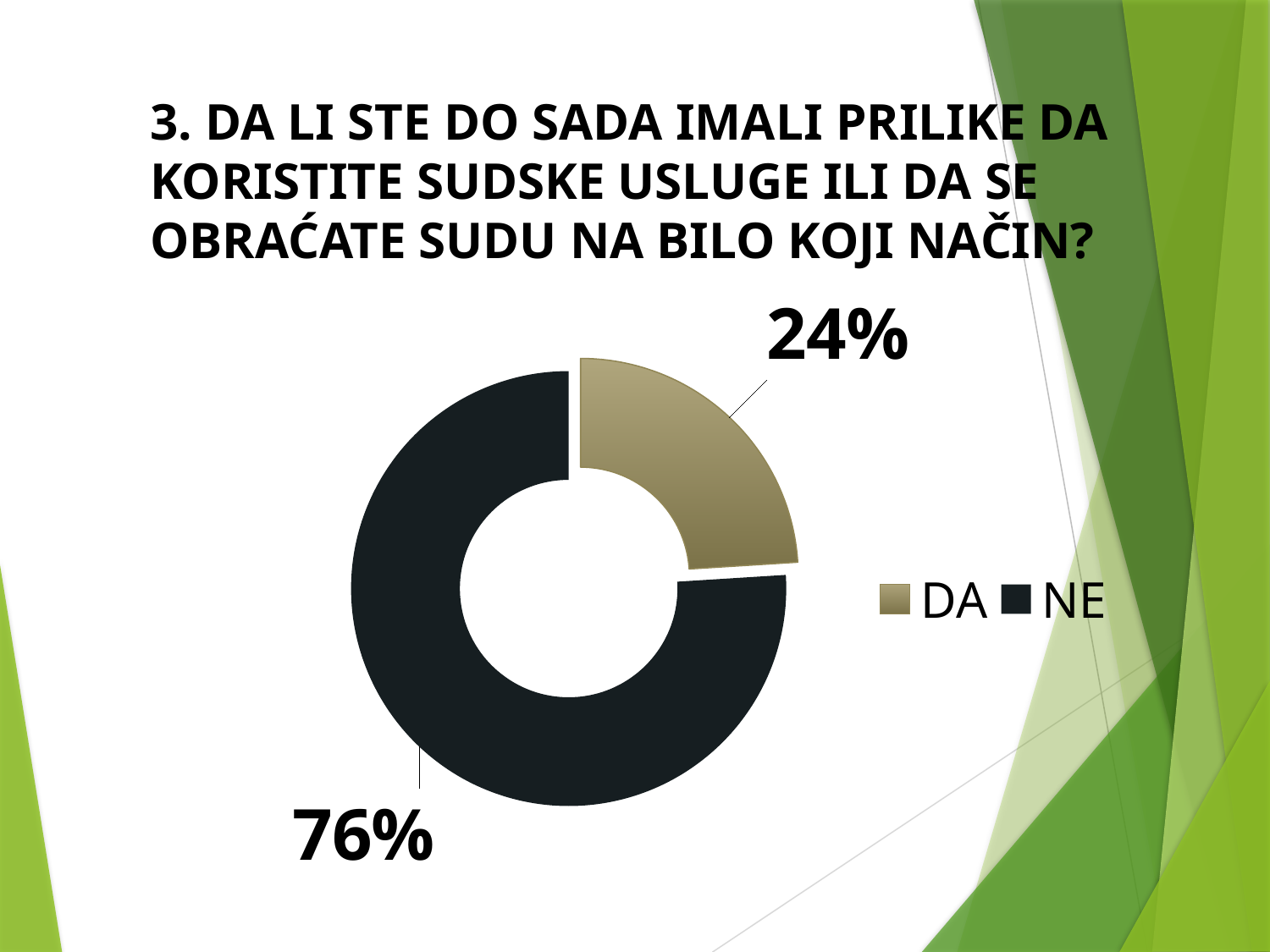
Which is larger, the share for DA or the share for NE? NE Which category has the smallest share in the chart? DA How many categories are shown in the chart? 2 Which category has the largest share in the chart? NE What kind of chart is shown on the slide? Doughnut (pie) chart How many entries does the legend list? 2 What share of the chart does the NE slice represent? 76% Is the share for NE greater or less than 50%? greater What colour is the NE slice in the chart? Black What colour is the DA slice in the chart? Tan/gold What share of the chart does the DA slice represent? 24% What is the difference in percentage points between the NE and DA shares? 52